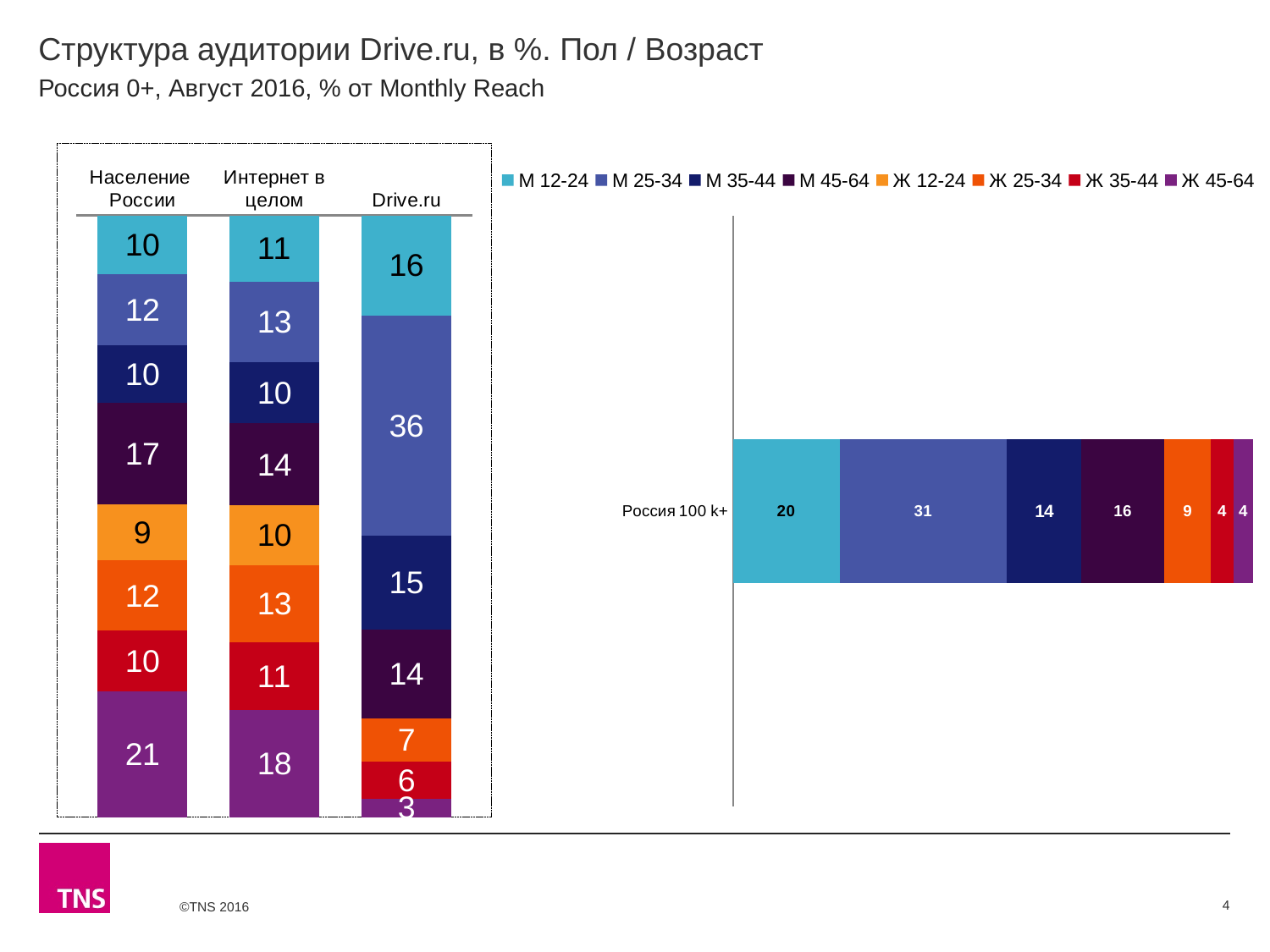
In the right chart, which series has the largest segment for Россия 100 k+? М 25-34 In the left chart, which has the larger Ж 45-64 value: Население России or Интернет в целом? Население России In the right chart, what is the difference between the М 12-24 and М 35-44 values for Россия 100 k+? 6 In the left chart, what is the value of the М 25-34 segment for Drive.ru? 36 In the left chart, what is the value of the М 45-64 segment for Интернет в целом? 14 In the right chart, what is the value of the М 25-34 segment for Россия 100 k+? 31 In the left chart, which series has the largest segment in the Drive.ru bar? М 25-34 In the left chart, what is the value of the Ж 45-64 segment for Население России? 21 How many categories (bars) are shown in the left chart? 3 What kind of chart is the right chart? Stacked bar chart In the left chart, what is the difference between the М 25-34 value for Drive.ru and the М 25-34 value for Интернет в целом? 23 How many series does the legend list? 8